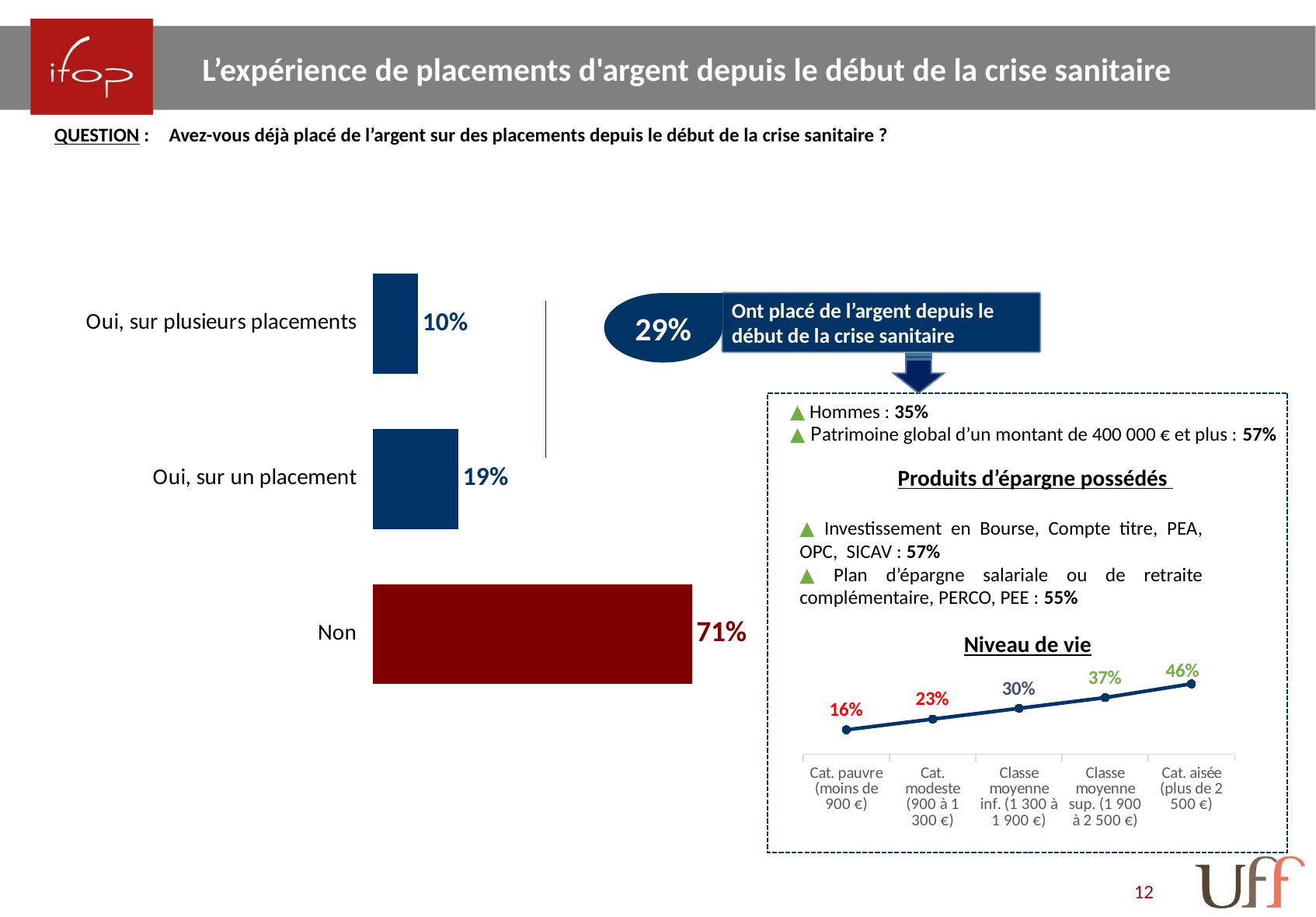
In the bar chart on the left, how many categories are shown? 3 In the bar chart on the left, what is the value for "Non"? 71% In the bar chart on the left, which category has the lowest value? Oui, sur plusieurs placements In the "Niveau de vie" chart, what is the difference between "Cat. aisée (plus de 2 500 €)" and "Cat. pauvre (moins de 900 €)"? 30% In the "Niveau de vie" chart, which category has the highest value? Cat. aisée (plus de 2 500 €) In the "Niveau de vie" chart, what is the value for "Classe moyenne inf. (1 300 à 1 900 €)"? 30% In the "Niveau de vie" chart, what is the value for "Cat. aisée (plus de 2 500 €)"? 46% In the bar chart on the left, what is the difference between "Non" and "Oui, sur un placement"? 52% What kind of chart is the chart on the left of the slide? Bar chart In the "Niveau de vie" chart, do the values rise or fall from left to right along the x axis? Rise In the bar chart on the left, what is the value for "Oui, sur un placement"? 19% What kind of chart is the "Niveau de vie" chart? Line chart